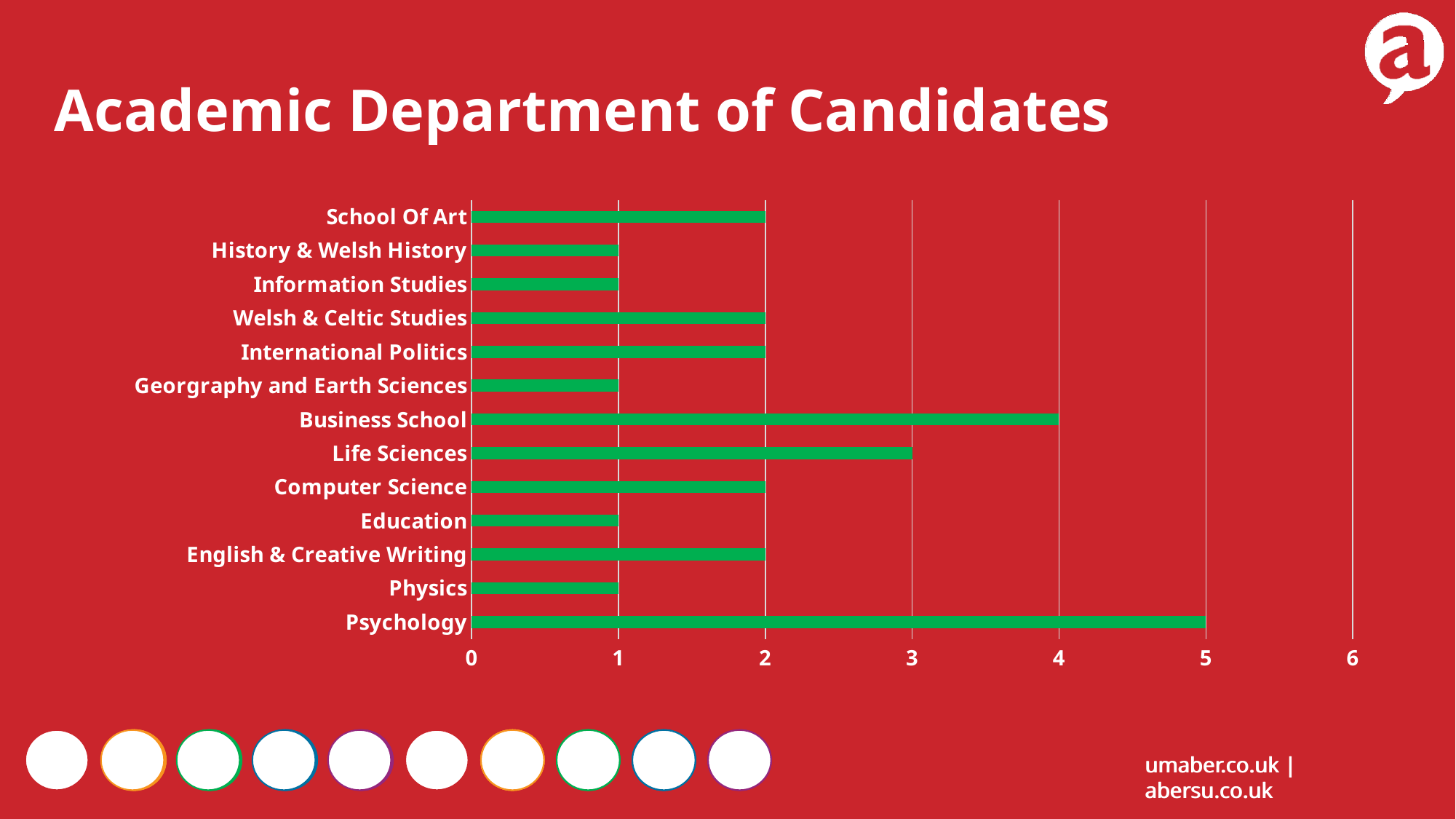
Is the value for Business School greater or less than 3? greater What is the value for Business School? 4 What is the value for Life Sciences? 3 Which is larger, the value for Life Sciences or the value for School Of Art? Life Sciences What is the value for Psychology? 5 What is the title of the chart? Academic Department of Candidates What type of chart is shown on the slide? Bar chart What is the difference between the values for Psychology and Business School? 1 What is the value for Computer Science? 2 How many departments are listed on the chart? 13 Which department has the highest number of candidates? Psychology What is the value for Physics? 1